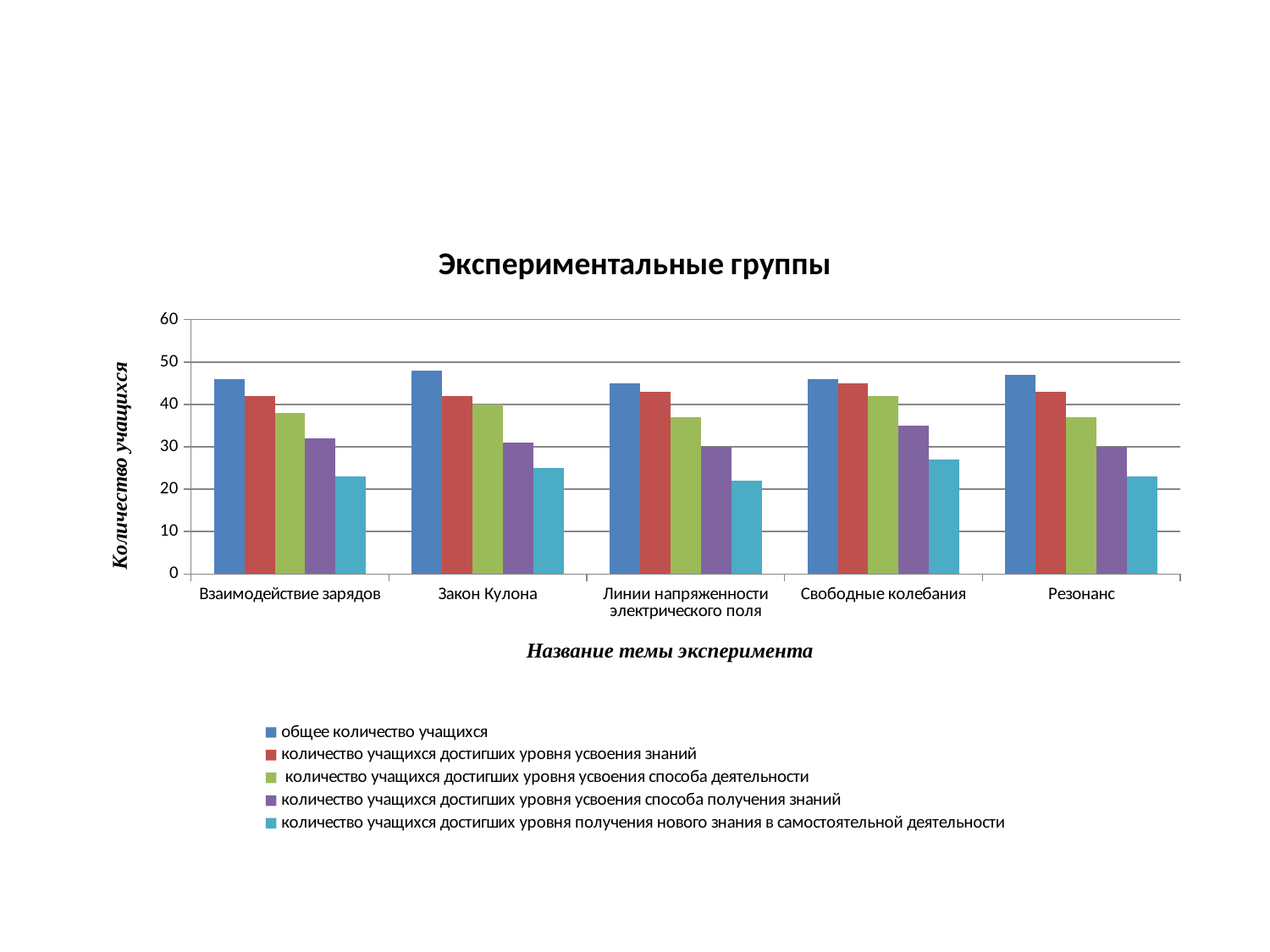
For the series 'количество учащихся достигших уровня получения нового знания в самостоятельной деятельности', which is larger: 'Свободные колебания' or 'Линии напряженности электрического поля'? Свободные колебания What is the label of the vertical axis? Количество учащихся Is the value of 'общее количество учащихся' for 'Закон Кулона' greater or less than 40? greater Is the value of 'количество учащихся достигших уровня получения нового знания в самостоятельной деятельности' for 'Линии напряженности электрического поля' greater or less than 30? less Is the value of 'количество учащихся достигших уровня усвоения способа получения знаний' for 'Взаимодействие зарядов' greater or less than 30? greater How many experiment topics (categories) are shown on the x axis? 5 How many series does the legend list? 5 Within the 'Резонанс' group, do the bars rise or fall from left to right across the series? fall What is the title of the chart? Экспериментальные группы What kind of chart is shown on the slide? bar chart Which topic has the highest value for 'количество учащихся достигших уровня получения нового знания в самостоятельной деятельности'? Свободные колебания